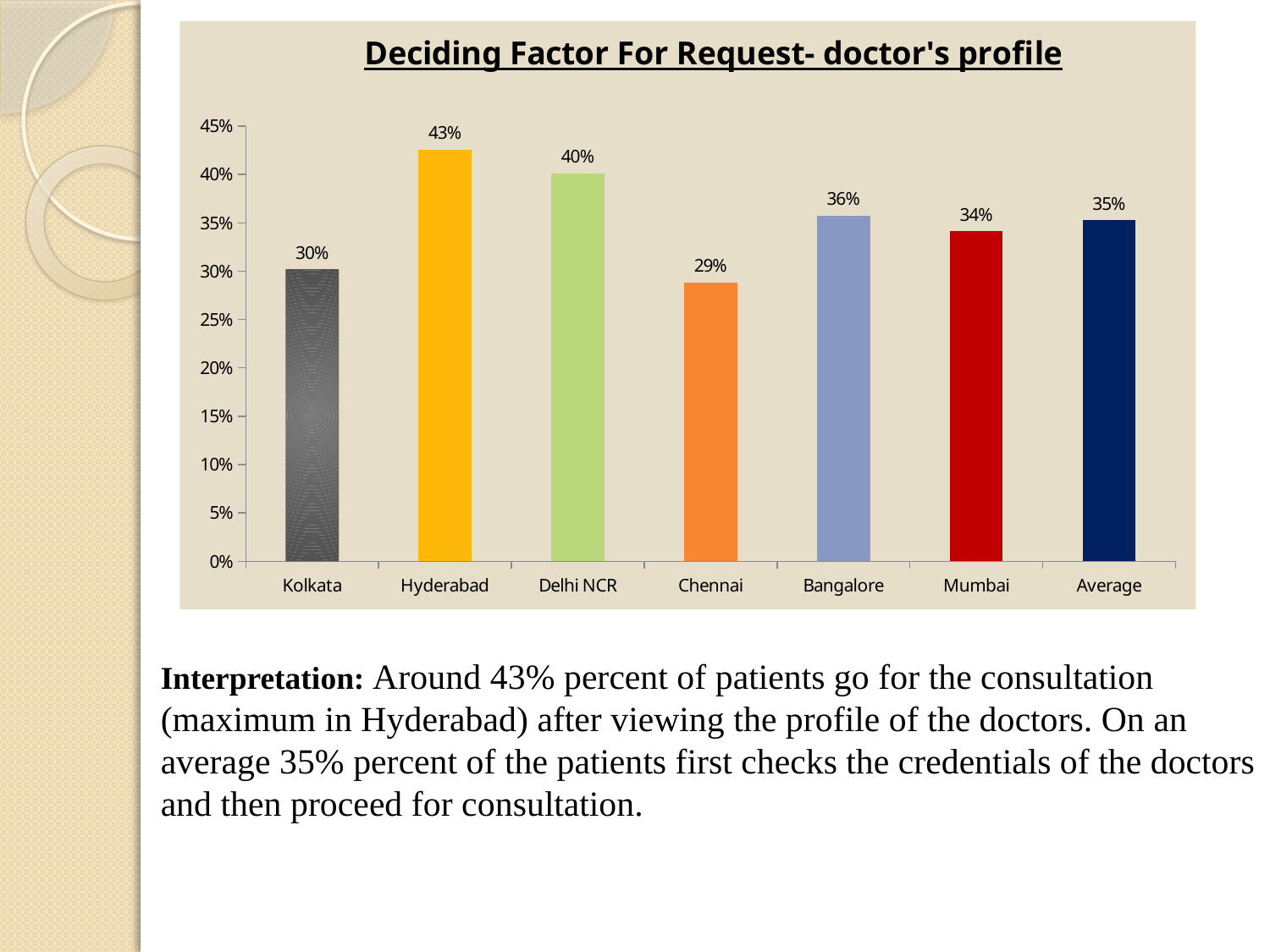
Which is larger, the value for Delhi NCR or the value for Mumbai? Delhi NCR What is the value for Average? 35% What is the value for Hyderabad? 43% Which category has the lowest value? Chennai Is the value for Kolkata greater or less than 35%? less What is the title of the chart? Deciding Factor For Request- doctor's profile How many categories are shown on the x axis? 7 Which category has the highest value? Hyderabad What is the value for Bangalore? 36% What kind of chart is shown on the slide? bar chart What is the value for Chennai? 29% What is the difference between the values for Hyderabad and Kolkata? 13%